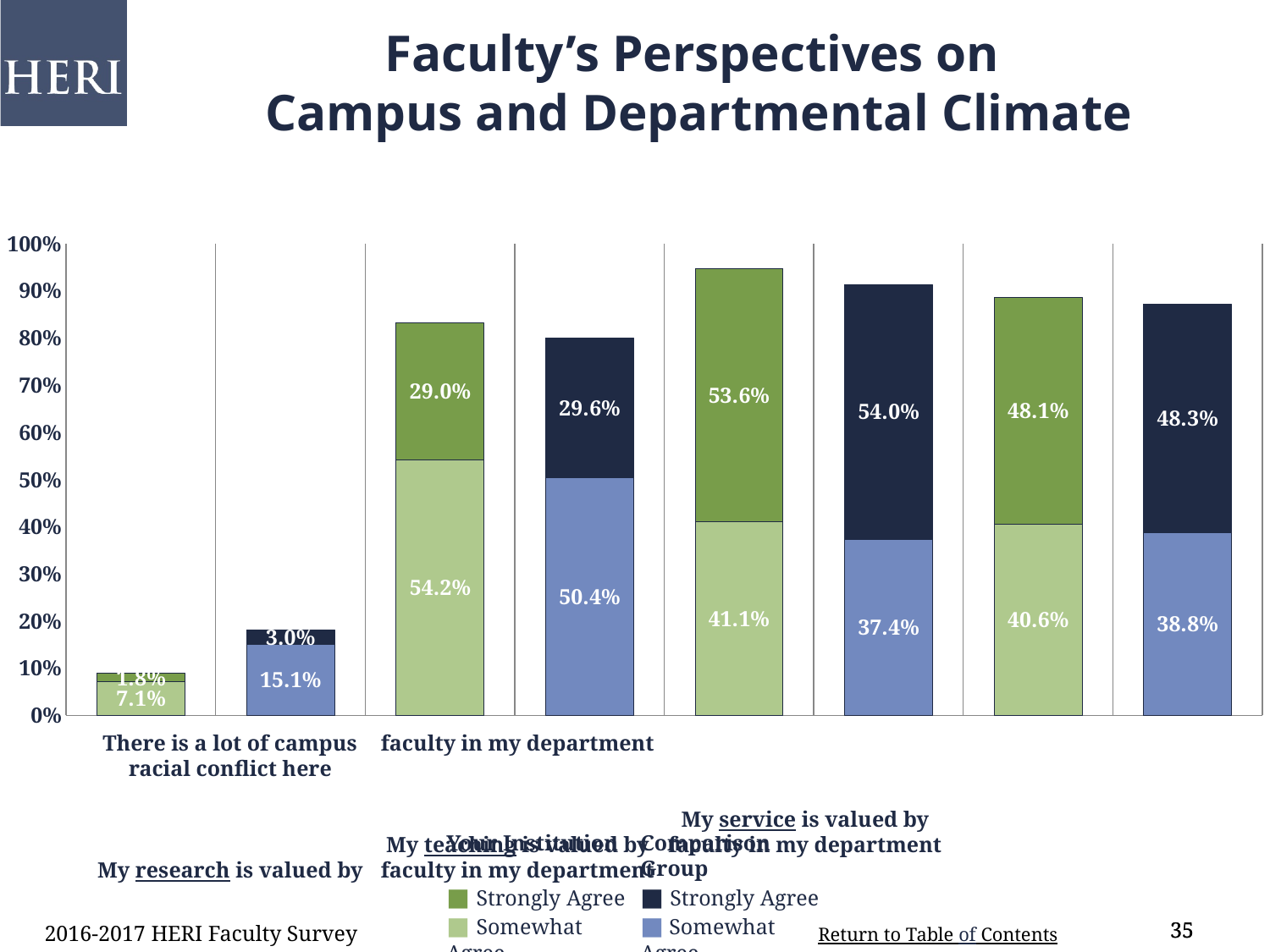
What percentage of Comparison Group faculty somewhat agree that their research is valued by faculty in their department? 50.4% What is the difference between the Your Institution and Comparison Group 'Somewhat Agree' percentages for 'My teaching is valued by faculty in my department'? 3.7% What is the total percentage of Comparison Group faculty who strongly or somewhat agree that their research is valued by faculty in their department? 80.0% Which is larger: the Your Institution 'Strongly Agree' percentage for 'My service is valued by faculty in my department' or the Comparison Group 'Strongly Agree' percentage for the same item? Comparison Group (48.3%) What percentage of Your Institution faculty somewhat agree that their service is valued by faculty in their department? 40.6% Which statement has the lowest total agreement for Your Institution? There is a lot of campus racial conflict here What is the total percentage of Your Institution faculty who strongly or somewhat agree that their teaching is valued by faculty in their department? 94.7% What percentage of Your Institution faculty strongly agree that their teaching is valued by faculty in their department? 53.6% What type of chart is shown on the slide? Stacked bar chart What is the title of the chart on the slide? Faculty's Perspectives on Campus and Departmental Climate What percentage of Comparison Group faculty strongly agree that there is a lot of campus racial conflict? 3.0% How many entries does the legend list? 4